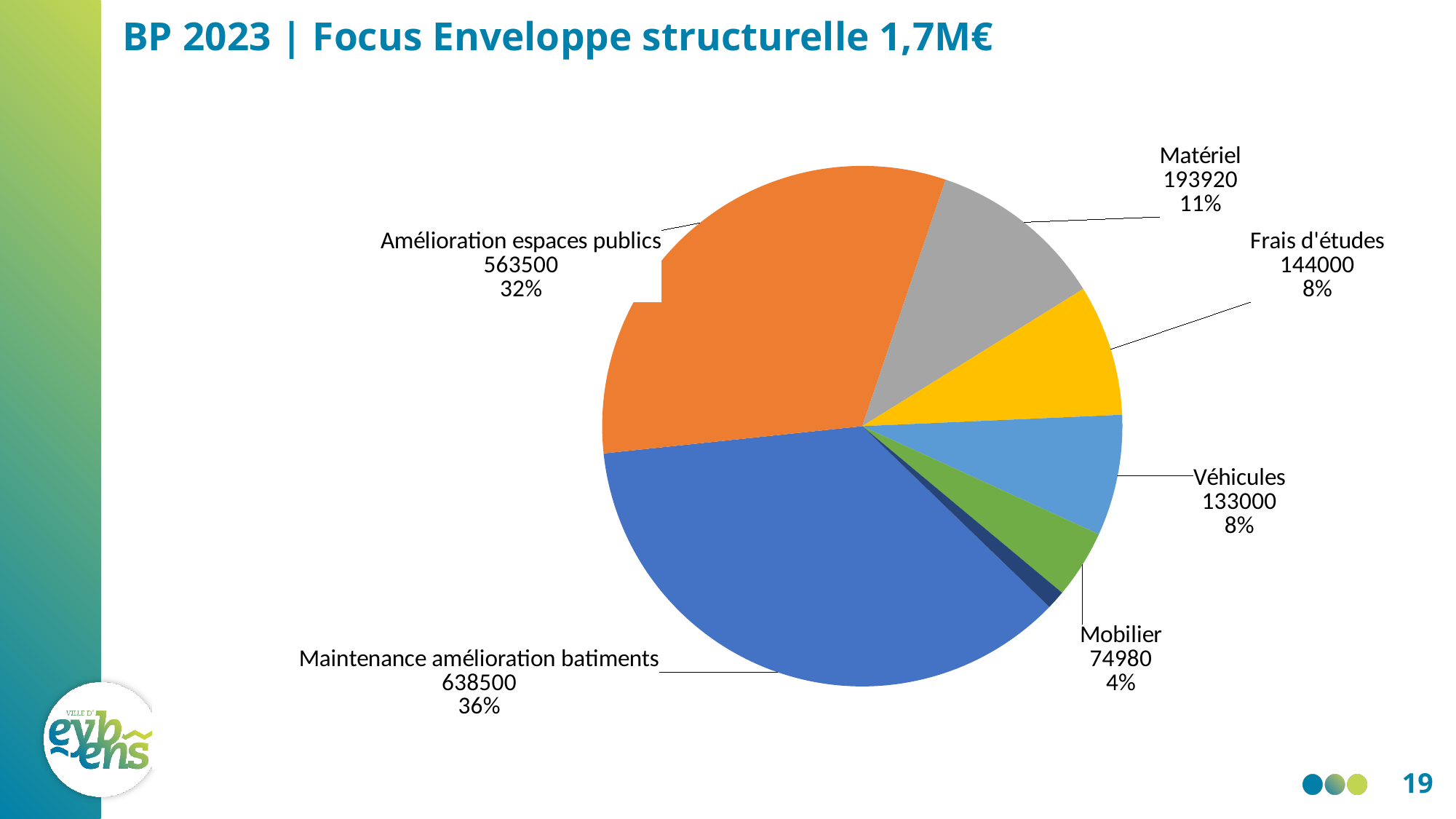
What is the title of the slide? BP 2023 | Focus Enveloppe structurelle 1,7M€ What share of the pie does Véhicules represent? 8% What is the difference between the values for Maintenance amélioration batiments and Amélioration espaces publics? 75000 Which is larger, the value for Matériel or the value for Frais d'études? Matériel What is the value for Amélioration espaces publics? 563500 Which category has the largest slice of the pie? Maintenance amélioration batiments What kind of chart is shown on the slide? pie chart What share of the pie does Mobilier represent? 4% What is the value for Mobilier? 74980 What is the value for Maintenance amélioration batiments? 638500 What is the value for Matériel? 193920 What share of the pie does Amélioration espaces publics represent? 32%